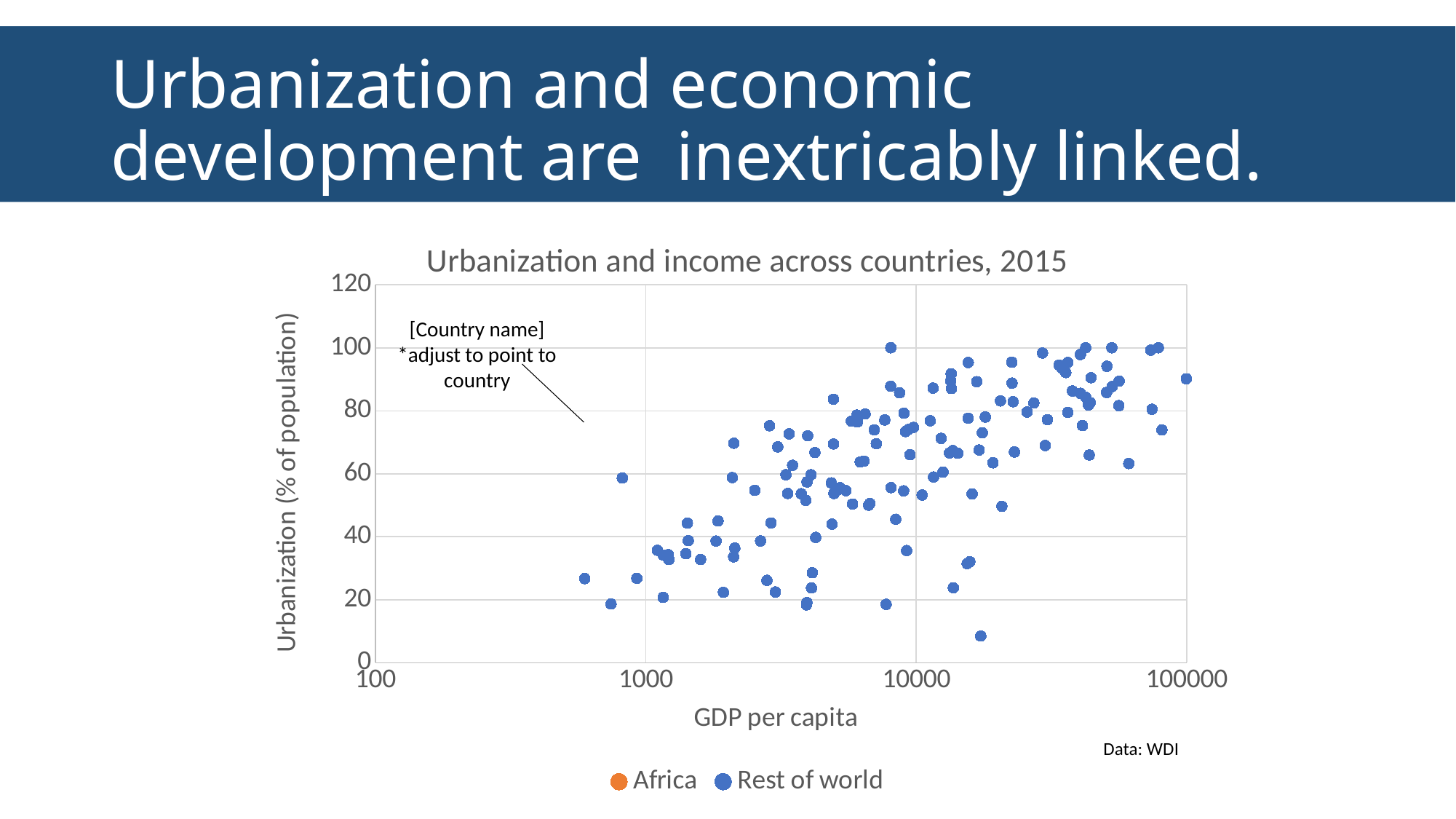
What is the title of the chart? Urbanization and income across countries, 2015 As GDP per capita increases along the x axis, does urbanization generally rise or fall? Rise Is the lowest plotted urbanization value greater or less than 20? less How many series does the legend of the chart list? 2 Is the highest plotted urbanization value greater or less than 80? greater What are the two series named in the chart's legend? Africa and Rest of world What kind of chart is shown on the slide? Scatter chart Is the lowest plotted GDP per capita value greater or less than 1000? less